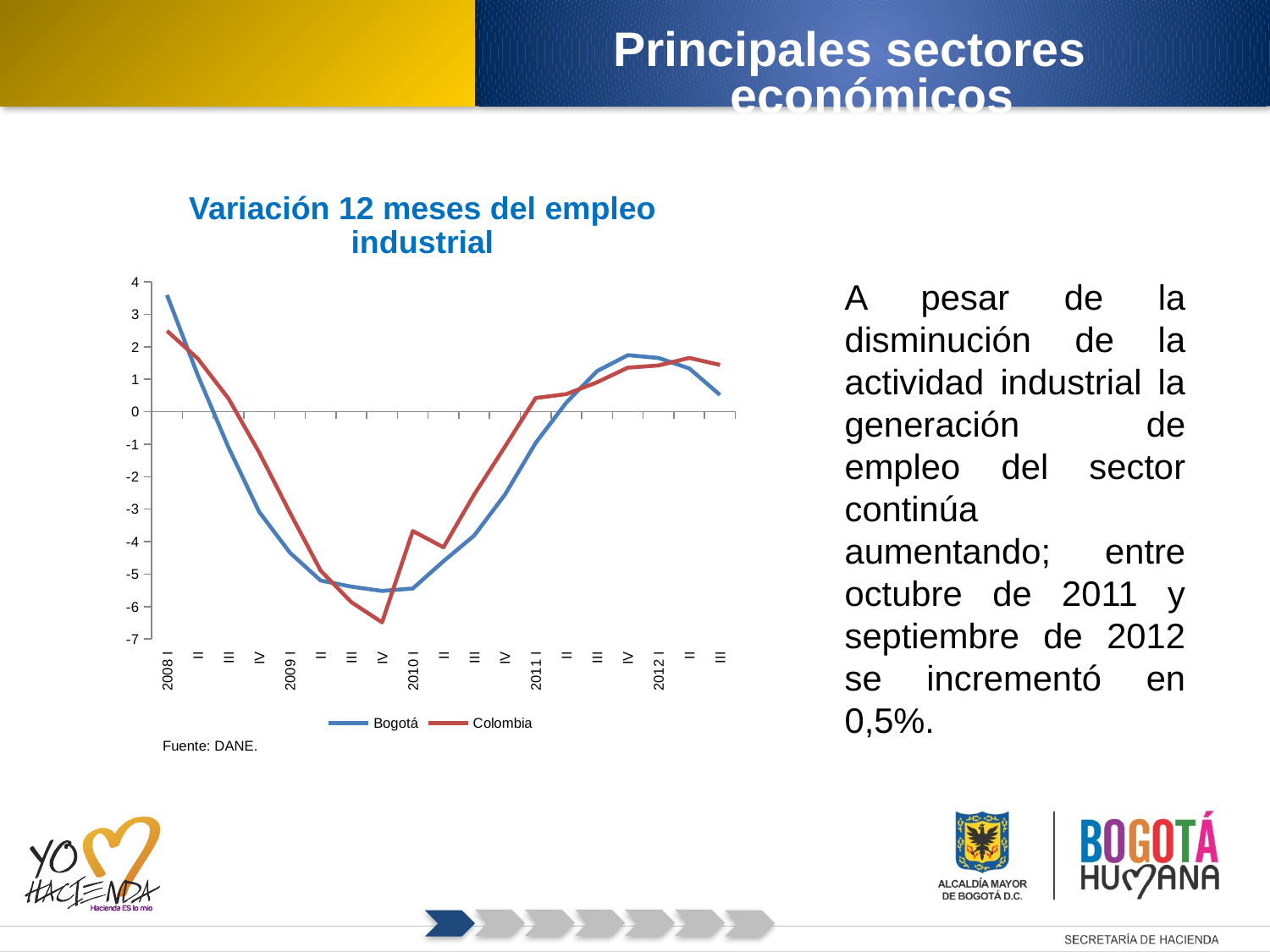
How many series does the legend list? 2 In which quarter does the Colombia series reach its lowest value? 2009 IV Is the value for Colombia at 2009 IV greater or less than -6? less Is the value for Bogotá at 2012 III greater or less than 1? less What kind of chart is shown on the slide? line chart Does the Colombia series rise or fall between 2008 I and 2009 IV? fall At 2008 I, which series has the higher value, Bogotá or Colombia? Bogotá At 2010 I, which series has the higher value, Bogotá or Colombia? Colombia Is the value for Bogotá at 2008 I greater or less than 3? greater What are the two series shown in the legend? Bogotá and Colombia How many quarterly points are plotted along the x axis, from 2008 I to 2012 III? 19 What is the title of the chart? Variación 12 meses del empleo industrial